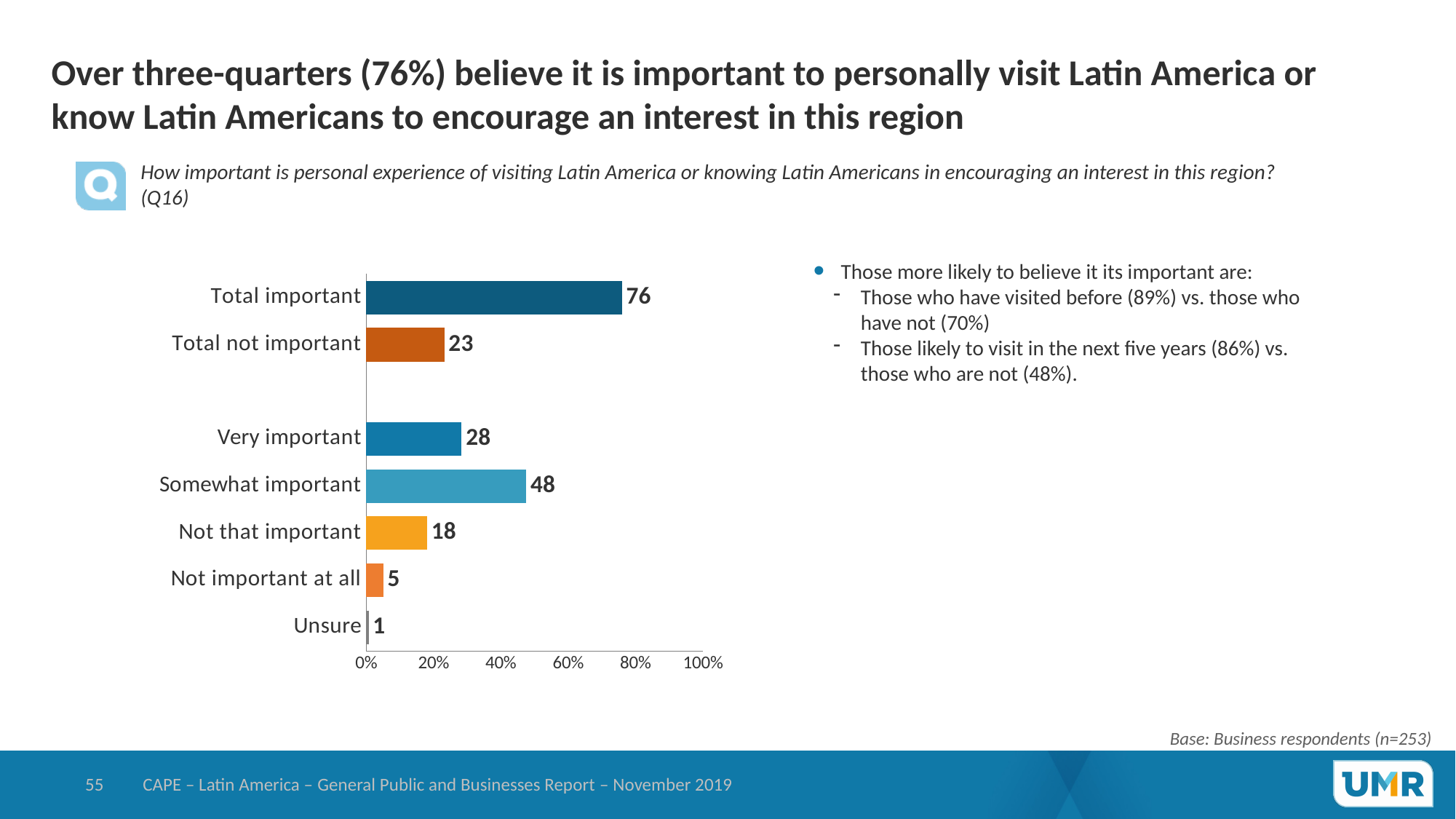
Which category has the lowest value? Unsure What kind of chart is shown? Bar chart Is the value for Somewhat important greater or less than 40%? greater What is the difference between Somewhat important and Very important? 20 What is the value for Not important at all? 5 What is the value for Unsure? 1 Which is larger, Not that important or Very important? Very important What is the value for Total important? 76 What is the value for Somewhat important? 48 What is the difference between Total important and Total not important? 53 How many categories are shown in the chart? 7 Which category has the highest value? Total important